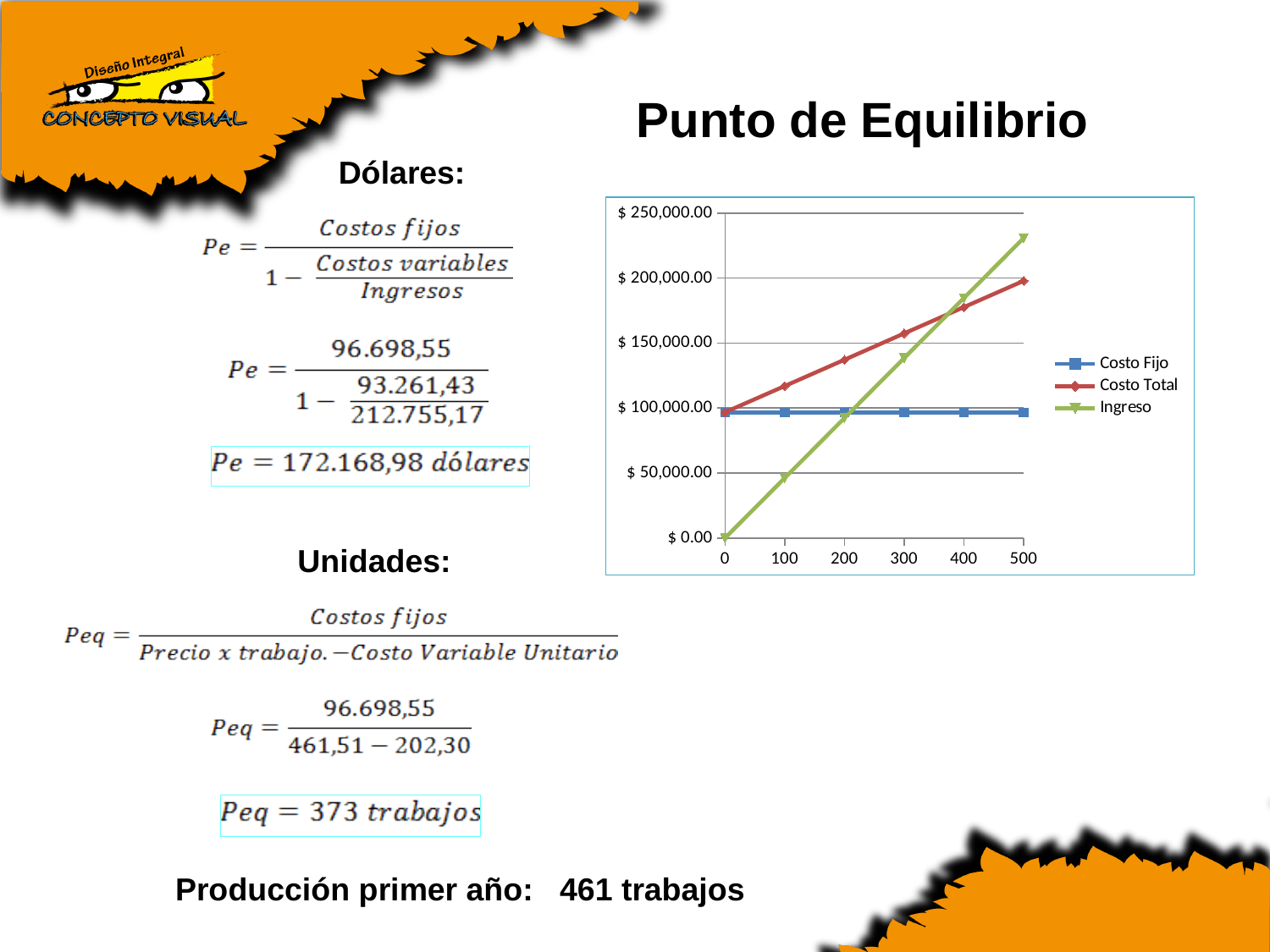
Does the Costo Fijo line rise, fall, or stay flat across the x axis? stays flat At 500 on the x axis, which is larger, Ingreso or Costo Total? Ingreso Does the Ingreso line rise or fall as the x axis increases? rises Is the value of Ingreso at 200 greater or less than $ 100,000.00? less Which series are listed in the chart legend? Costo Fijo, Costo Total, Ingreso How many x-axis points are plotted for each series in the chart? 6 Which series has the lowest value at 500 on the x axis? Costo Fijo Is the value of Costo Total at 100 greater or less than $ 100,000.00? greater What is the value of Ingreso at 0 units in the chart? $ 0.00 How many series does the chart legend list? 3 What kind of chart is shown on the slide? line chart Is the value of Ingreso at 500 greater or less than $ 200,000.00? greater